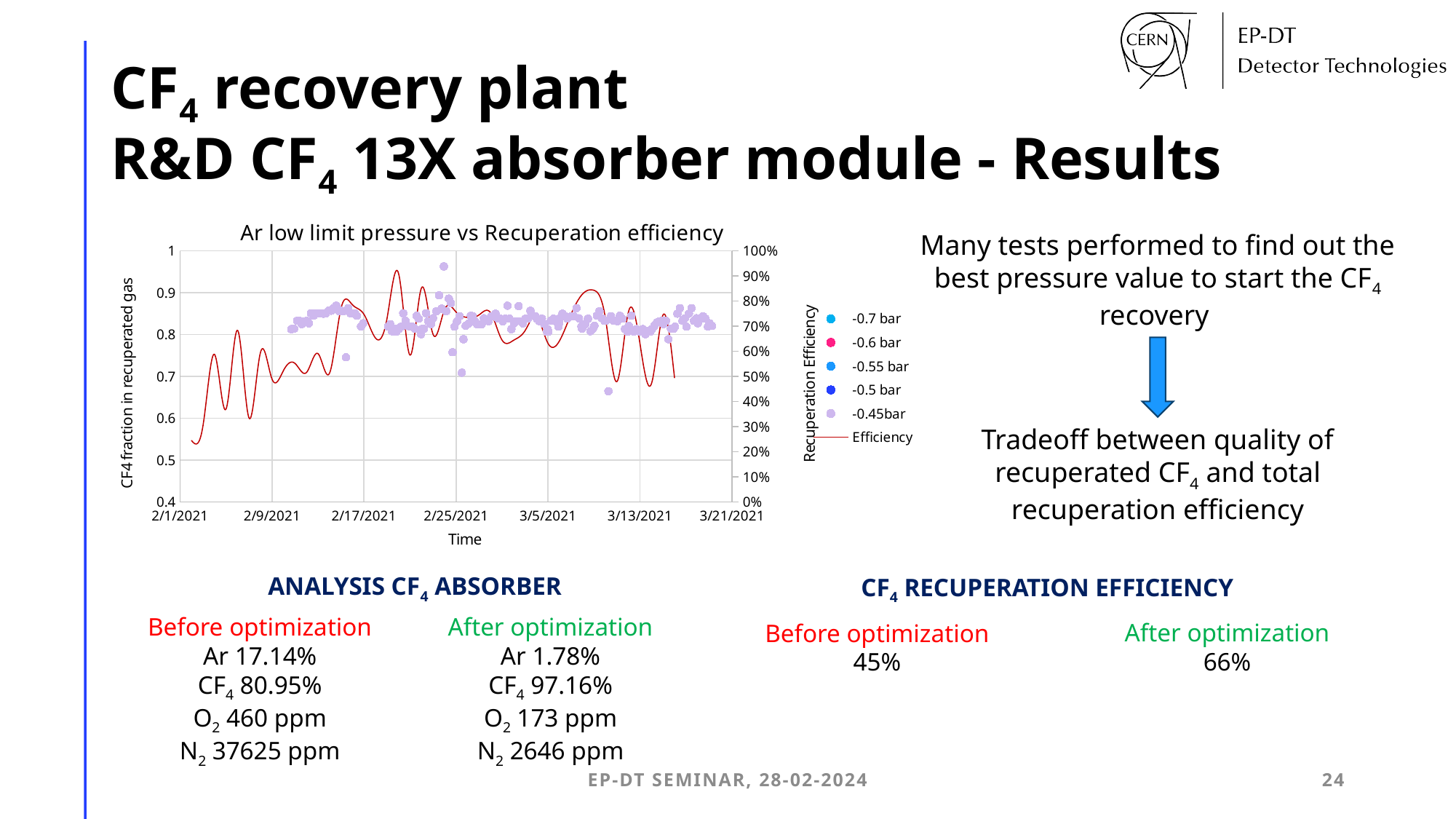
What is the title of the chart on the slide? Ar low limit pressure vs Recuperation efficiency What is the last date label on the x axis of the chart? 3/21/2021 What kind of chart is shown on the slide? scatter chart with a line series Is the Efficiency line at 2/1/2021 greater or less than 60% on the right axis? less What is the highest value shown on the right y axis of the chart? 100% Which legend series is plotted with light purple markers in the chart? -0.45bar What is the lowest value shown on the left y axis of the chart? 0.4 Is the lowest -0.45bar point on the chart greater or less than 0.7 on the left axis? less How many entries does the chart legend list? 6 Is the Efficiency line higher at its start on 2/1/2021 or at its peak around 2/21/2021? at its peak around 2/21/2021 How many date labels are shown on the x axis of the chart? 7 Is the highest peak of the Efficiency line greater or less than 80% on the right axis? greater